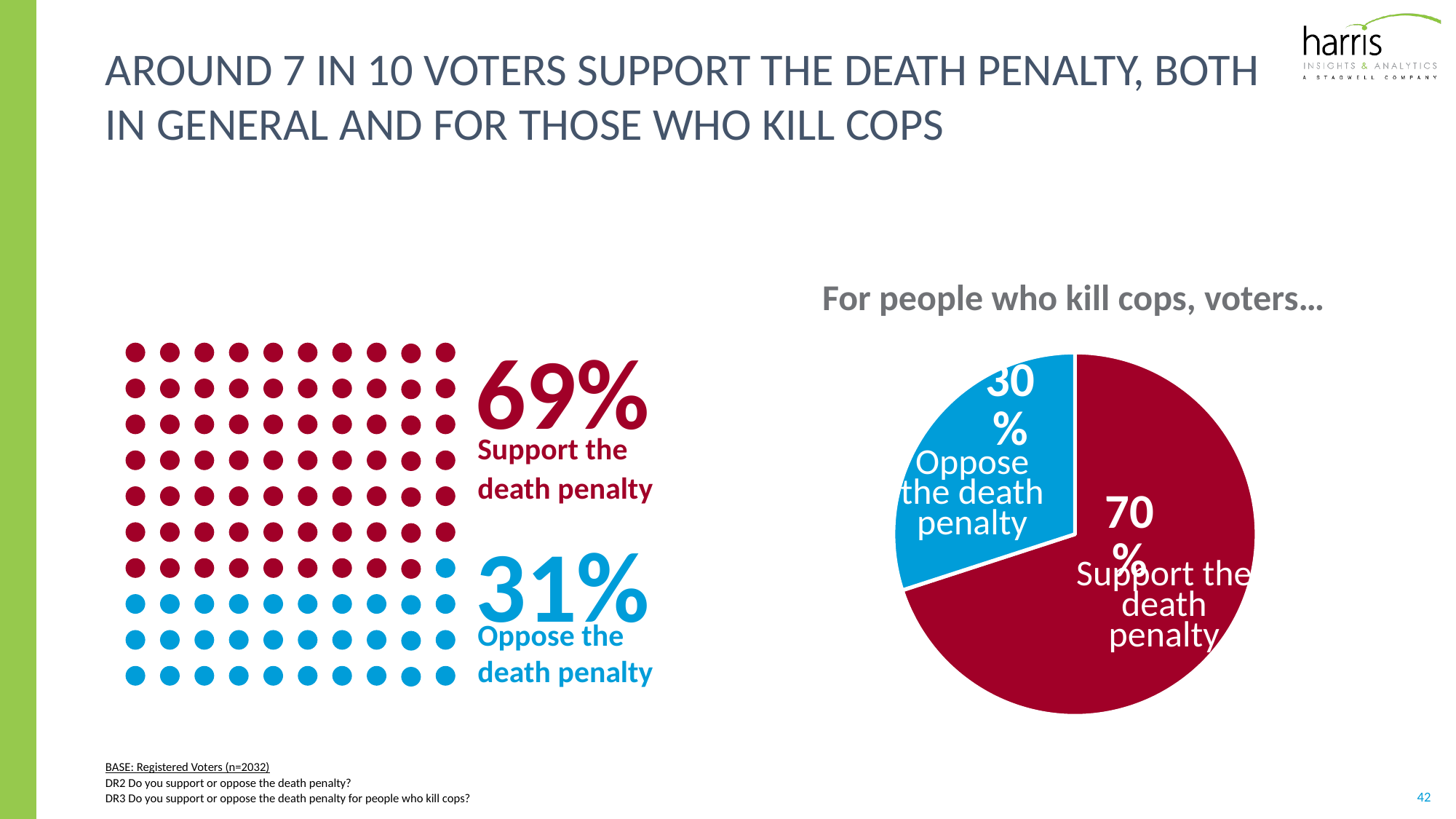
In the pie chart on the right, which slice is larger: support or oppose? Support the death penalty What kind of chart is shown on the right side of the slide? Pie chart In the dot chart on the left, what is the difference in percentage points between those who support and those who oppose the death penalty? 38 In the pie chart on the right, what colour is the slice for those who oppose the death penalty? Blue In the pie chart on the right, what share of voters support the death penalty for people who kill cops? 70% What is the title of the pie chart on the right? For people who kill cops, voters... In the pie chart on the right, what share of voters oppose the death penalty for people who kill cops? 30% In the dot chart on the left, what percentage of voters support the death penalty in general? 69% In the dot chart on the left, what percentage of voters oppose the death penalty in general? 31% In the pie chart on the right, what is the difference in percentage points between the support and oppose slices? 40 How many slices does the pie chart on the right have? 2 In the dot chart on the left, which group is smaller: those who support or those who oppose the death penalty? Oppose the death penalty